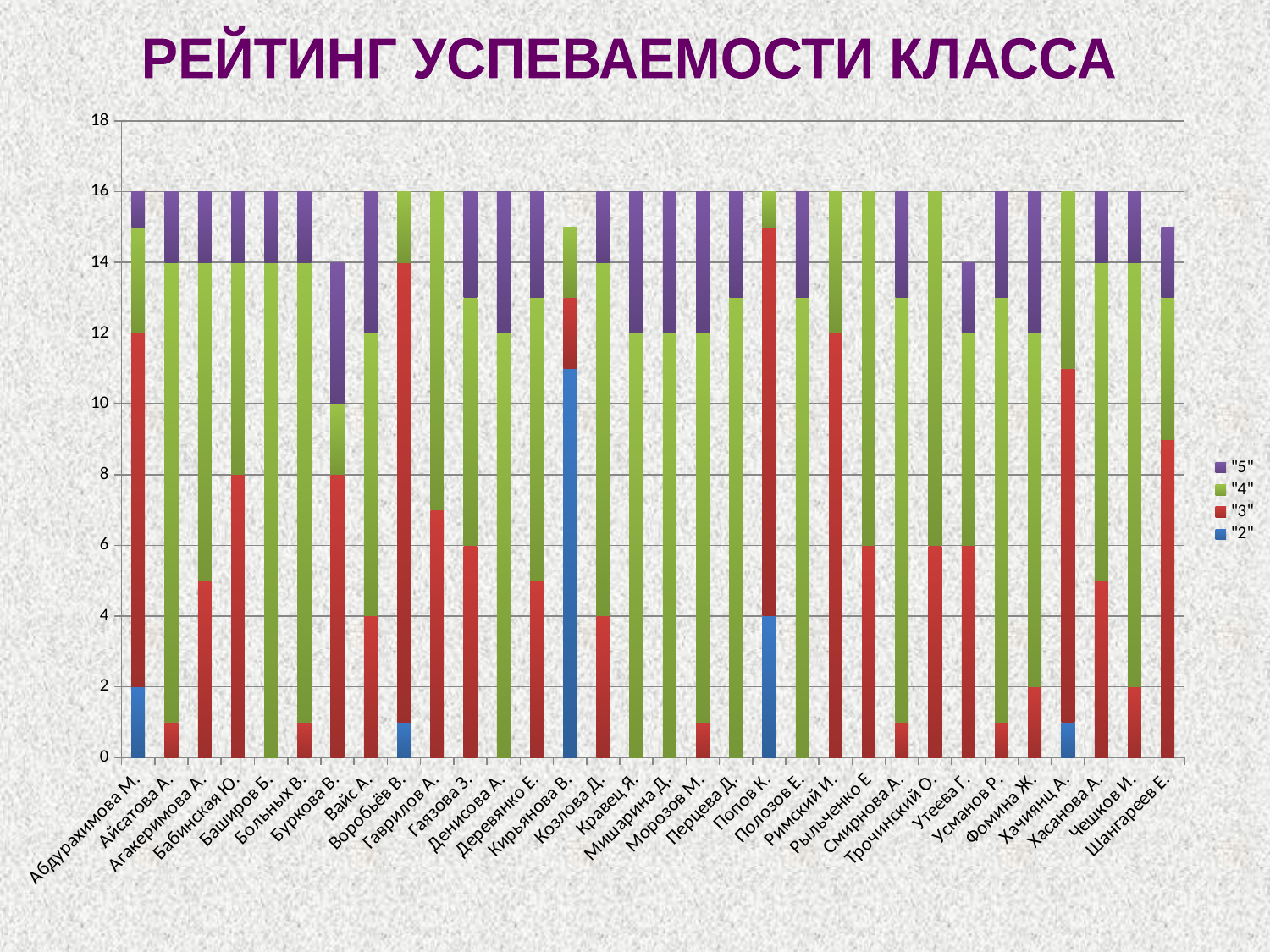
Which colour represents the "5" series in the legend? Purple Which student has the tallest "2" segment? Кирьянова В. Is the "2" value for Кирьянова В. greater or less than 10? greater How many series does the legend list? 4 Is the "3" value for Римский И. greater or less than 10? greater How many students (categories) are shown on the x axis? 32 What is the title of the chart? РЕЙТИНГ УСПЕВАЕМОСТИ КЛАССА Is the total bar height for Буркова В. greater or less than 15? less Which has the larger "3" segment, Римский И. or Бабинская Ю.? Римский И. What kind of chart is shown on the slide? Stacked bar chart Which has the larger "2" segment, Кирьянова В. or Попов К.? Кирьянова В.